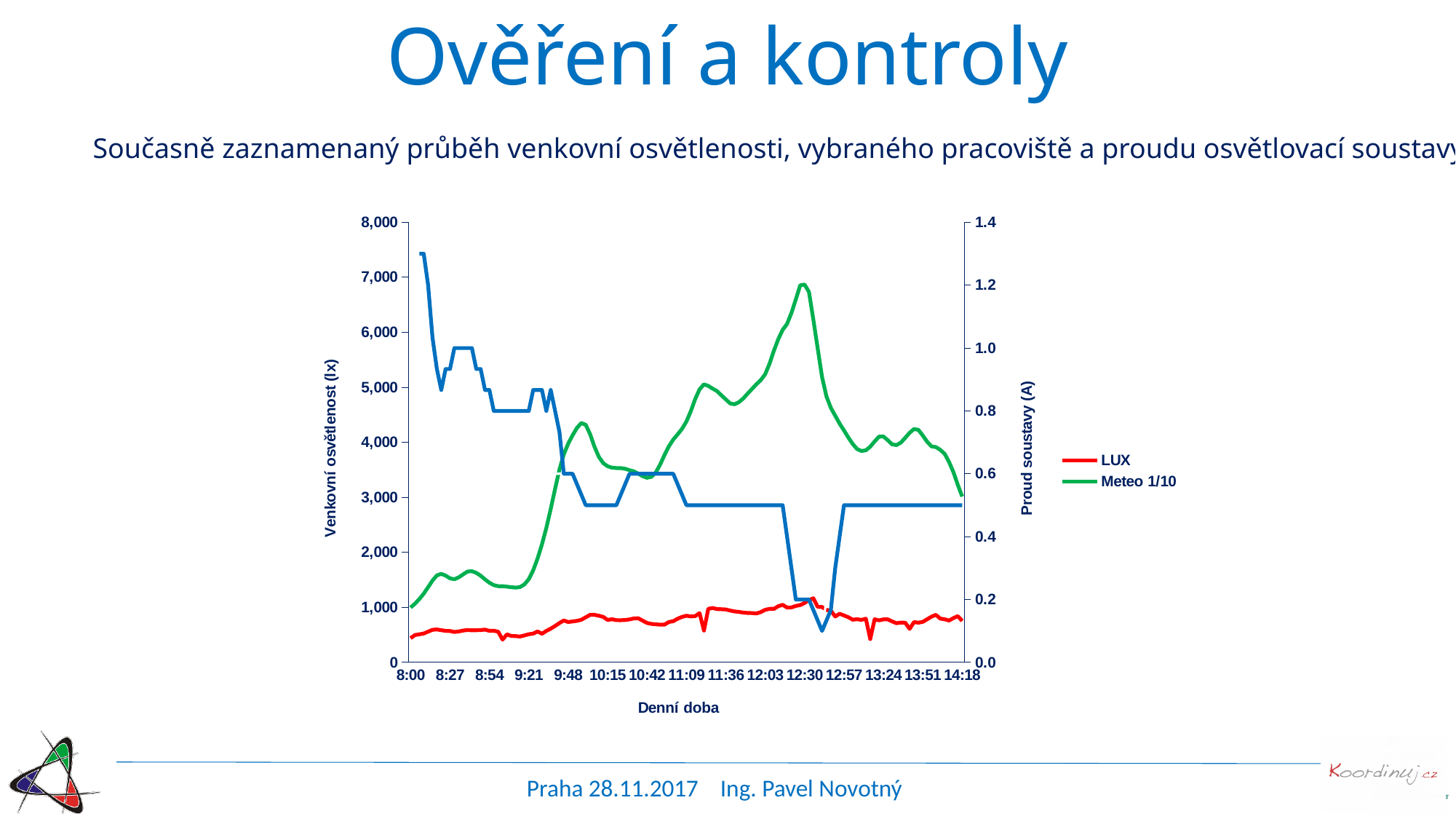
What is the highest tick value shown on the right vertical axis? 1.4 What is the label of the left vertical axis of the chart? Venkovní osvětlenost (lx) What kind of chart is shown on the slide? line chart What colour is the LUX series line in the chart? red What is the label of the x axis of the chart? Denní doba How many time ticks are labelled on the x axis? 15 What is the highest tick value shown on the left vertical axis? 8,000 How many series does the chart legend list? 2 What are the first and last time ticks on the x axis? 8:00 and 14:18 What is the label of the right vertical axis of the chart? Proud soustavy (A) Does the blue line overall rise or fall from 8:00 to 14:18? fall What are the two series named in the chart legend? LUX and Meteo 1/10